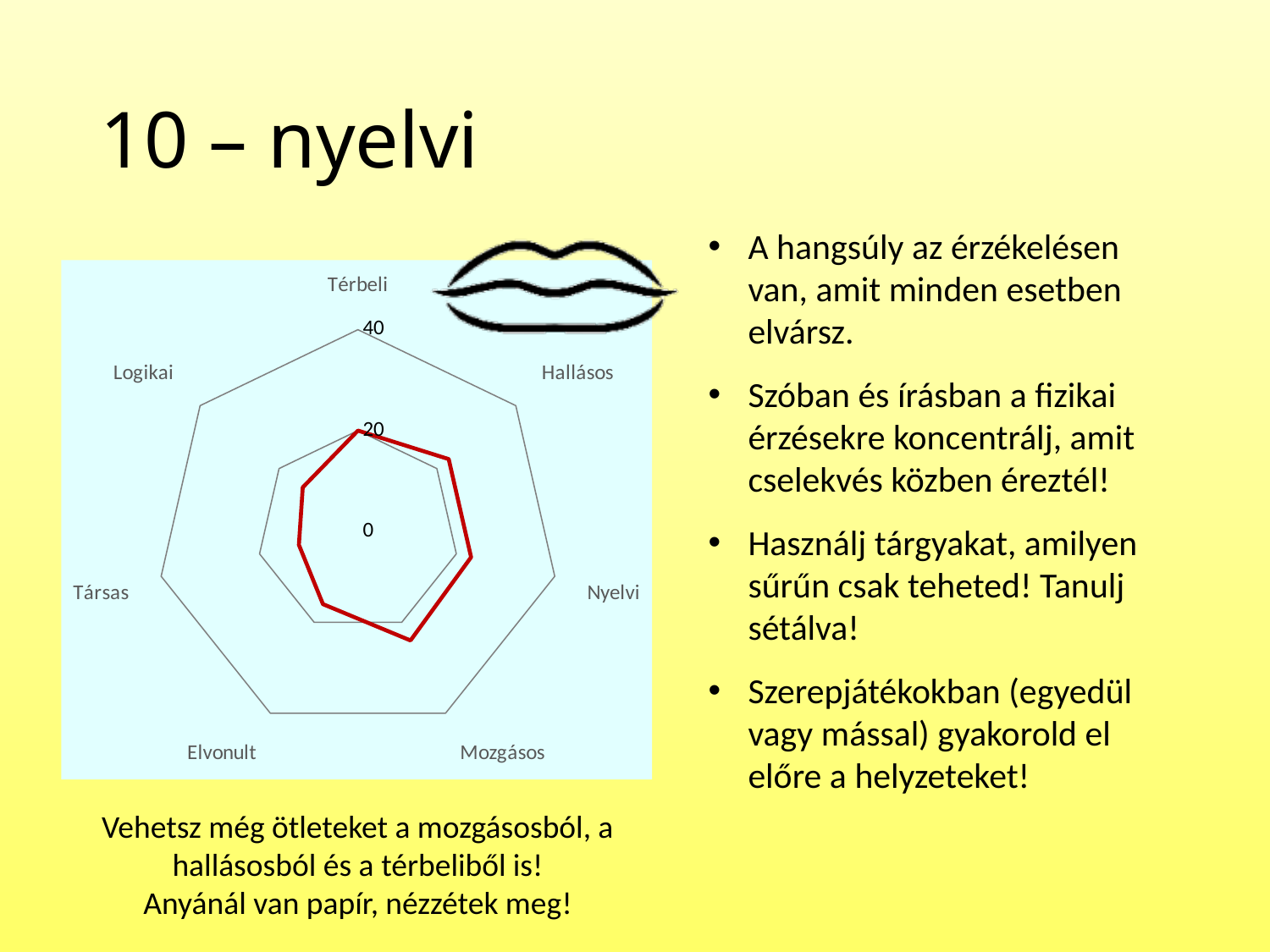
Is the value for Mozgásos greater or less than 20? greater What kind of chart is shown on the slide? radar chart Is the value for Társas greater or less than 20? less Is the value for Logikai greater or less than 20? less What is the highest value shown on the radar chart's axis scale? 40 What colour is the data line on the radar chart? red How many categories (axes) does the radar chart have? 7